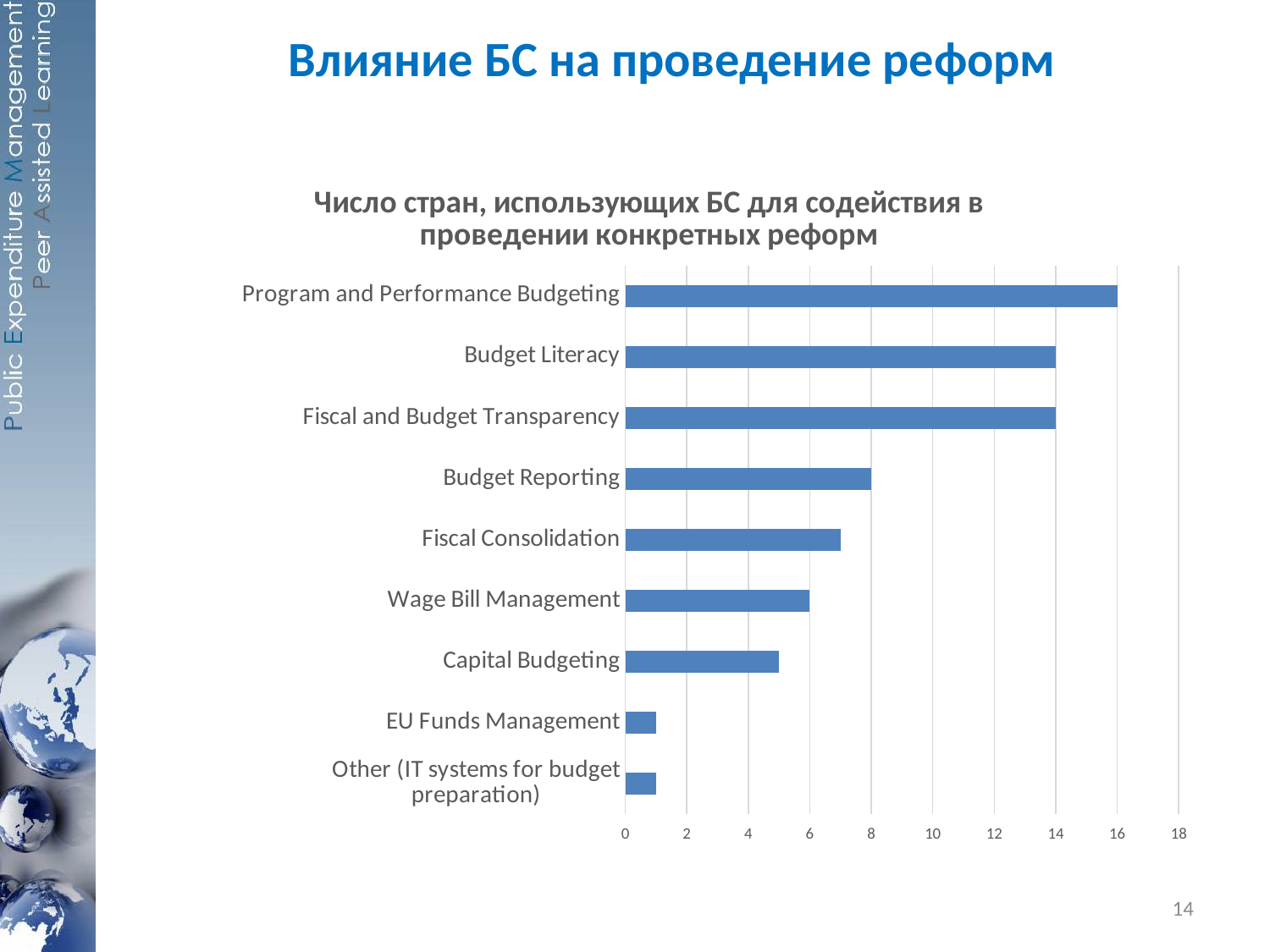
What is the difference between the values for Program and Performance Budgeting and Fiscal and Budget Transparency? 2 What is the value for Wage Bill Management? 6 Is the value for Capital Budgeting greater or less than 6? less How many reform categories are shown in the chart? 9 What is the value for Budget Reporting? 8 Is the value for Fiscal Consolidation greater or less than 6? greater What is the value for Budget Literacy? 14 Which category has the highest value? Program and Performance Budgeting What type of chart is shown on the slide? bar chart Which is larger, the value for Budget Reporting or the value for Wage Bill Management? Budget Reporting What is the value for Program and Performance Budgeting? 16 What is the difference between the values for Budget Literacy and Budget Reporting? 6